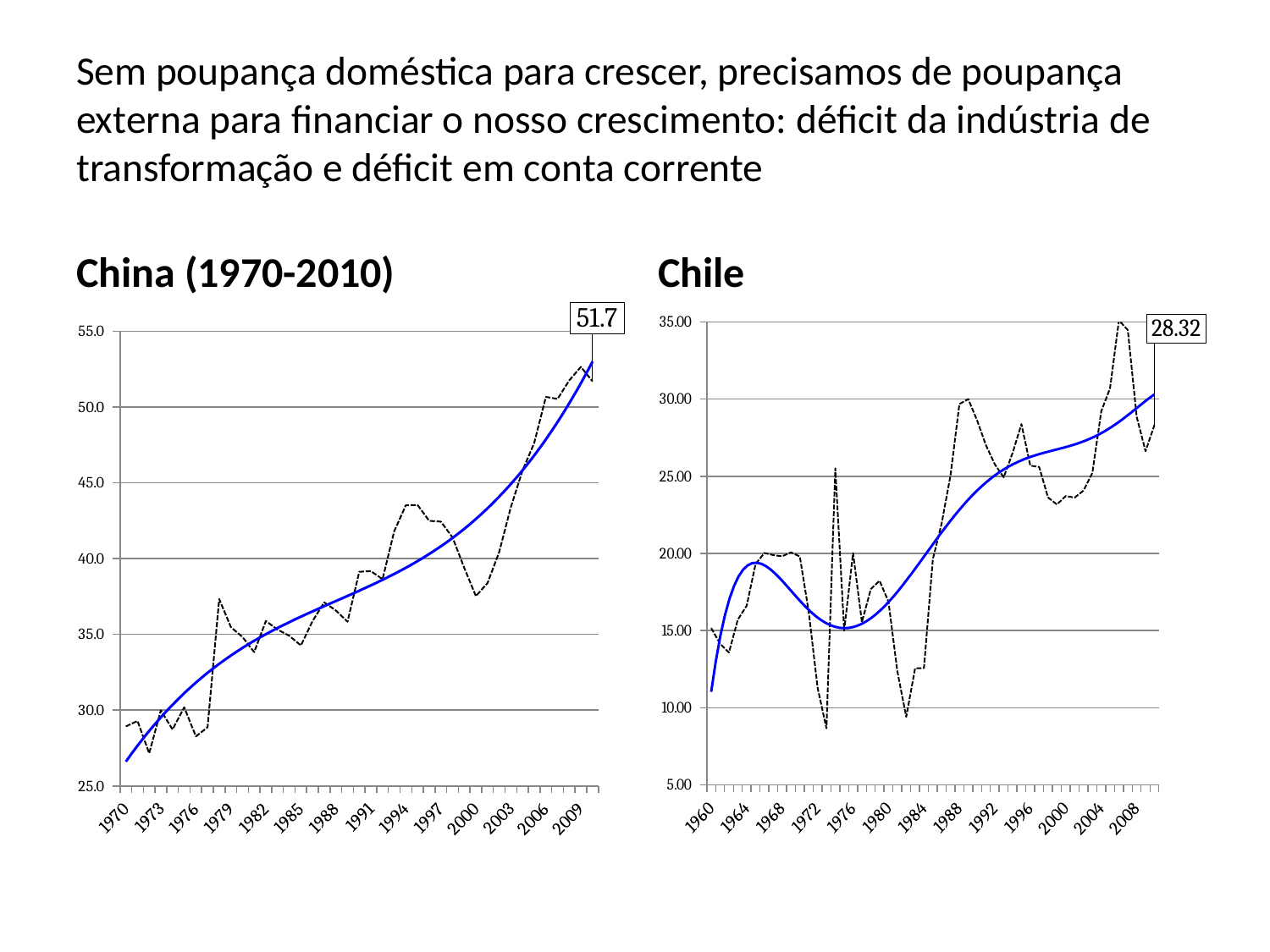
How many charts are shown on the slide? 2 On the Chile chart, is the lowest value around 1973 greater or less than 10.00? less On the China (1970-2010) chart, what value is shown by the data label at the end of the series? 51.7 On the Chile chart, is the value around 1982 greater or less than 10.00? less What kind of chart is the China (1970-2010) chart? line chart On the China (1970-2010) chart, is the peak value around 1994 greater or less than 40.0? greater What is the title of the chart on the left of the slide? China (1970-2010) On the Chile chart, does the value overall rise or fall from 1960 to 2008? rise On the China (1970-2010) chart, does the smooth trend line rise or fall from 1970 to 2009? rise On the Chile chart, what value is shown by the data label at the end of the series? 28.32 What kind of chart is the Chile chart? line chart